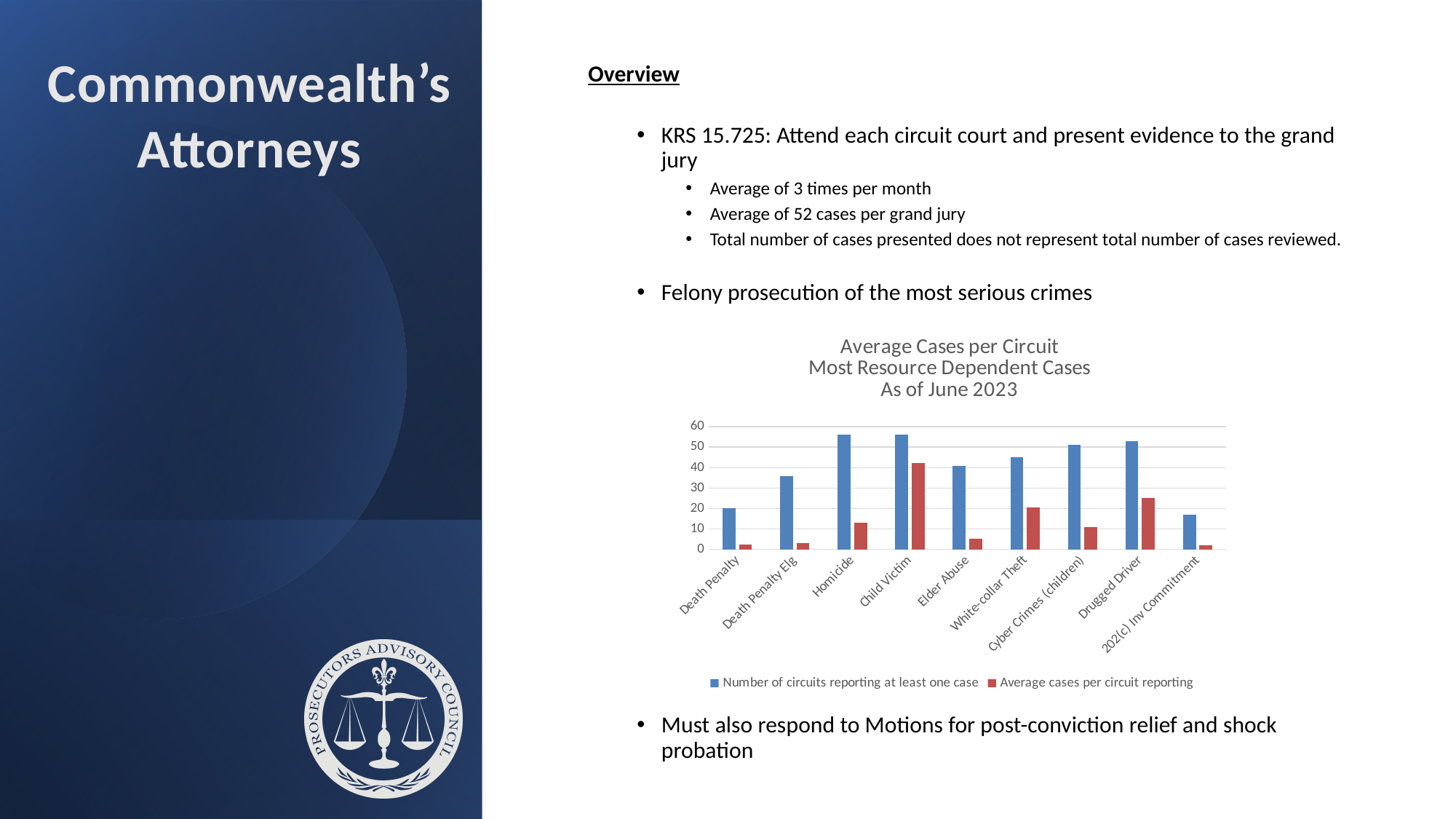
Is the value for Number of circuits reporting at least one case for Homicide greater or less than 50? greater Which is larger: Average cases per circuit reporting for Child Victim or for Homicide? Child Victim What date does the chart title say the data is as of? June 2023 Is the value for Average cases per circuit reporting for Child Victim greater or less than 40? greater How many series does the chart legend list? 2 Is the value for Average cases per circuit reporting for Elder Abuse greater or less than 10? less Which category has the highest value for Average cases per circuit reporting? Child Victim What kind of chart is shown on the slide? bar chart How many case categories are shown on the x axis of the chart? 9 Which is larger: Number of circuits reporting at least one case for Drugged Driver or for Elder Abuse? Drugged Driver